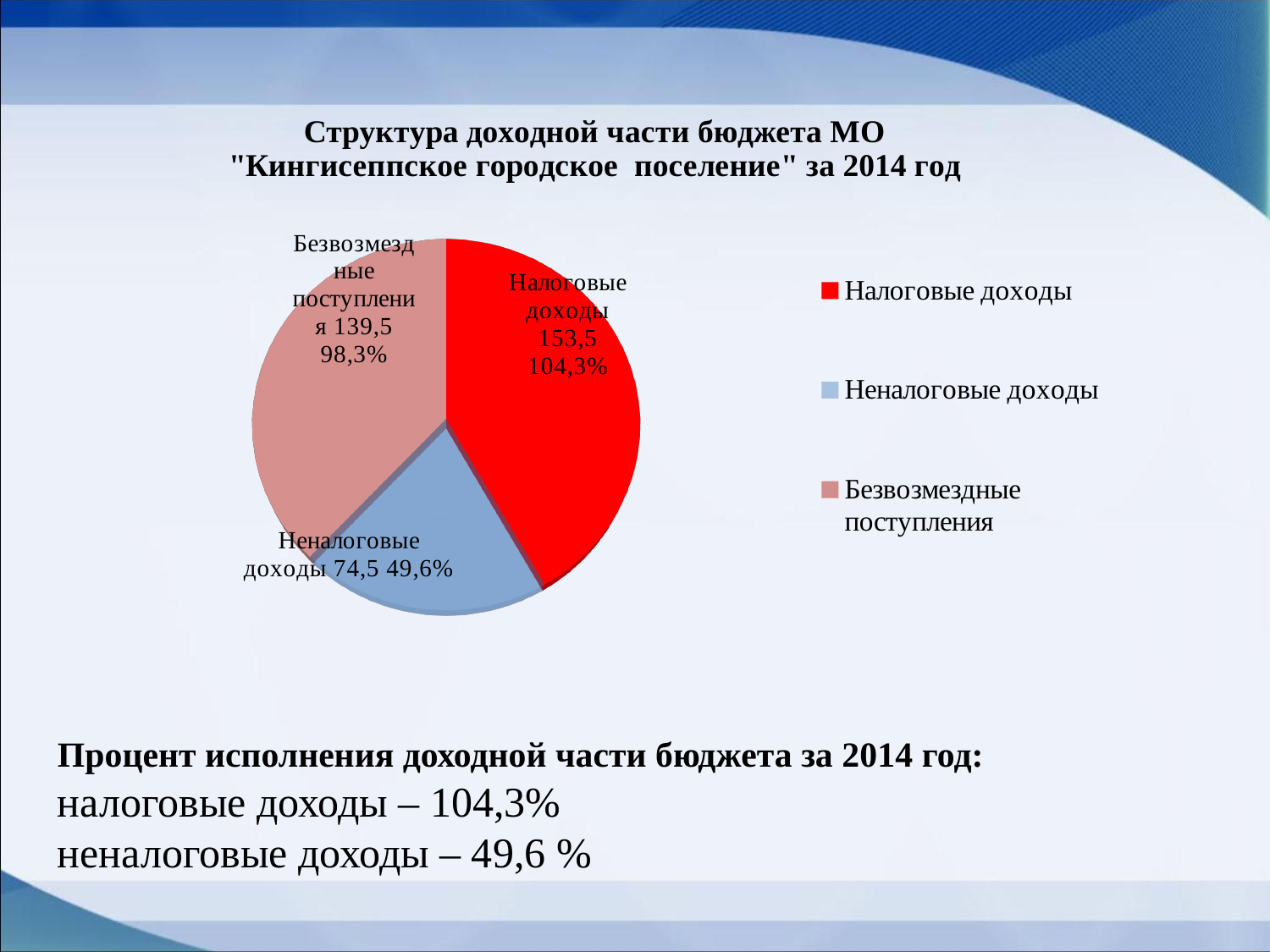
How many slices does the pie chart have? 3 What percentage is printed next to Безвозмездные поступления on the pie chart? 98,3% Which category has the largest slice of the pie chart? Налоговые доходы What value is shown for Неналоговые доходы on the pie chart? 74,5 What colour is the slice for Налоговые доходы? Red What value is shown for Налоговые доходы on the pie chart? 153,5 What is the difference between the values for Налоговые доходы and Неналоговые доходы? 79,0 What value is shown for Безвозмездные поступления on the pie chart? 139,5 What percentage is printed next to Налоговые доходы on the pie chart? 104,3% What type of chart is shown on the slide? Pie chart Which is larger, the value for Безвозмездные поступления or the value for Неналоговые доходы? Безвозмездные поступления Which category has the smallest slice of the pie chart? Неналоговые доходы